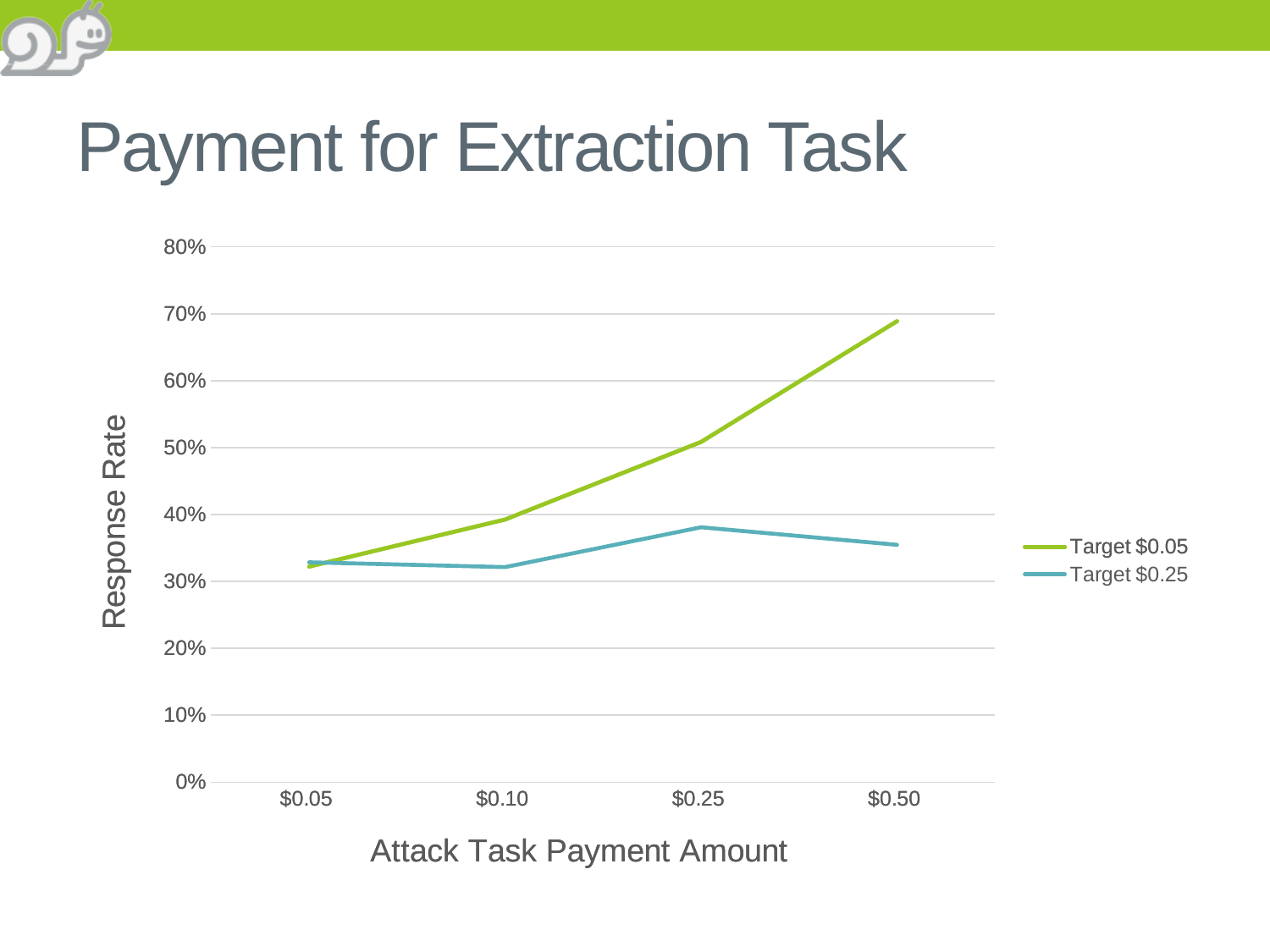
Is the response rate for Target $0.05 at $0.25 greater or less than 40%? greater What is the title of the chart's y axis? Response Rate At which attack task payment amount does the Target $0.05 series reach its highest response rate? $0.50 At an attack task payment of $0.50, which series has the higher response rate, Target $0.05 or Target $0.25? Target $0.05 Is the response rate for Target $0.25 at $0.10 greater or less than 40%? less What is the title of the chart's x axis? Attack Task Payment Amount Is the response rate for Target $0.25 at $0.50 greater or less than 40%? less How many payment amounts are shown on the x axis? 4 How many series does the legend list? 2 What kind of chart is shown on the slide? line chart Does the response rate for Target $0.05 rise or fall as the attack task payment amount increases? rise